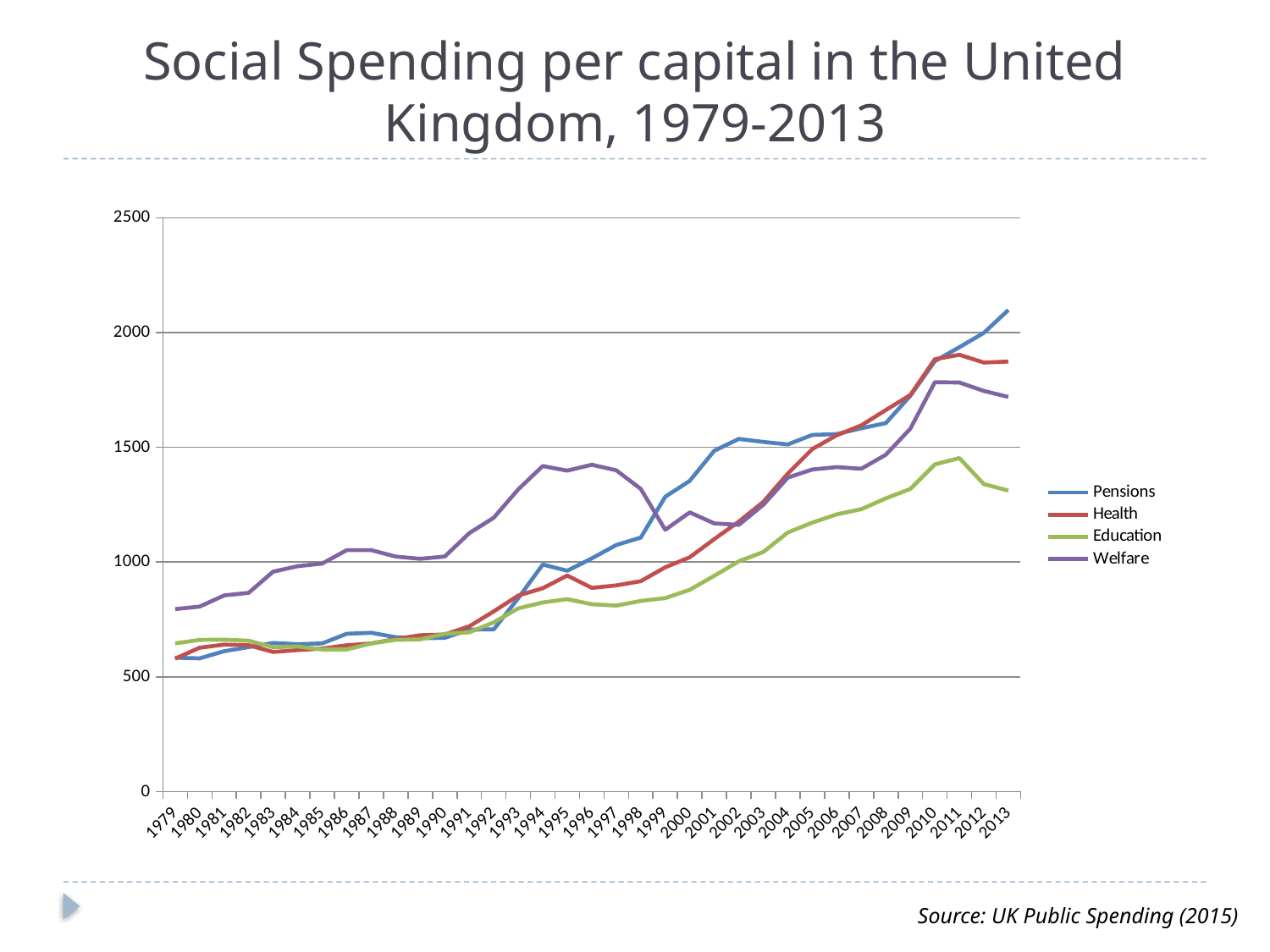
What kind of chart is shown on the slide? Line chart Does the Pensions line generally rise or fall from 1979 to 2013? Rise Which series has the lowest value in 2013? Education What is the title of the chart? Social Spending per capital in the United Kingdom, 1979-2013 In 1996, which is larger: Welfare or Education? Welfare Is the value for Pensions in 2013 greater or less than 2000? greater Is the value for Welfare in 1979 greater or less than 1000? less How many series does the legend list? 4 Which series has the highest value in 2013? Pensions Which series has the highest value in 1990? Welfare Is the value for Education in 2011 greater or less than 1500? less How many years are plotted along the x axis? 35